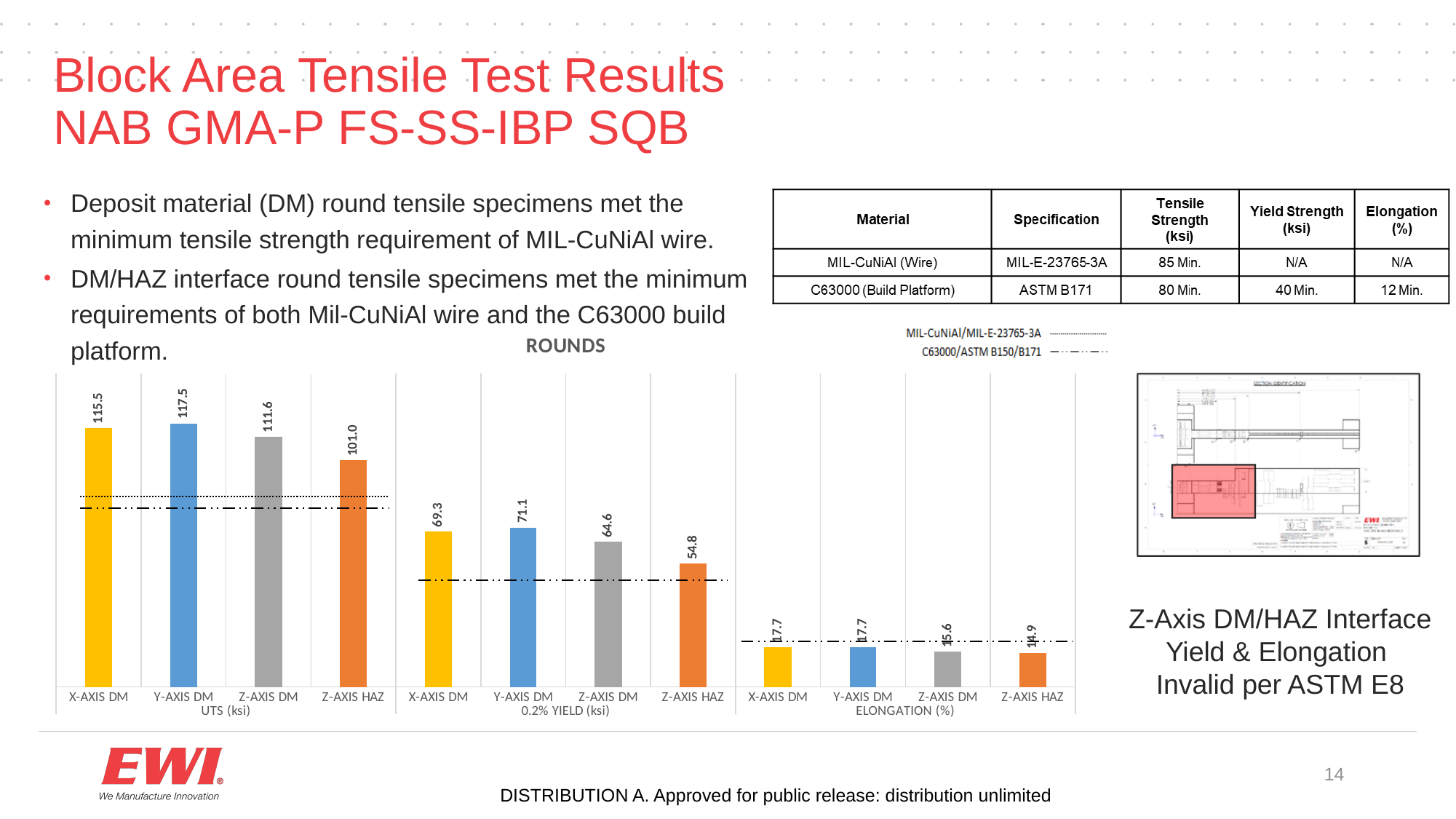
In the ROUNDS chart, which category has the lowest 0.2% YIELD (ksi) value? Z-AXIS HAZ What kind of chart is the ROUNDS chart? Bar chart What is the title of the chart on the slide? ROUNDS In the ROUNDS chart, what is the difference between the UTS (ksi) values for X-AXIS DM and Z-AXIS HAZ? 14.5 In the ROUNDS chart, what is the ELONGATION (%) value for Z-AXIS DM? 15.6 In the ROUNDS chart, what is the UTS (ksi) value for Z-AXIS DM? 111.6 In the ROUNDS chart, which has the larger 0.2% YIELD (ksi) value, X-AXIS DM or Y-AXIS DM? Y-AXIS DM In the ROUNDS chart, what is the difference between the 0.2% YIELD (ksi) values for Y-AXIS DM and Z-AXIS DM? 6.5 In the ROUNDS chart, what is the 0.2% YIELD (ksi) value for Z-AXIS HAZ? 54.8 How many bars are in the UTS (ksi) group of the ROUNDS chart? 4 In the ROUNDS chart, what is the UTS (ksi) value for Y-AXIS DM? 117.5 In the ROUNDS chart, which category has the highest UTS (ksi) value? Y-AXIS DM